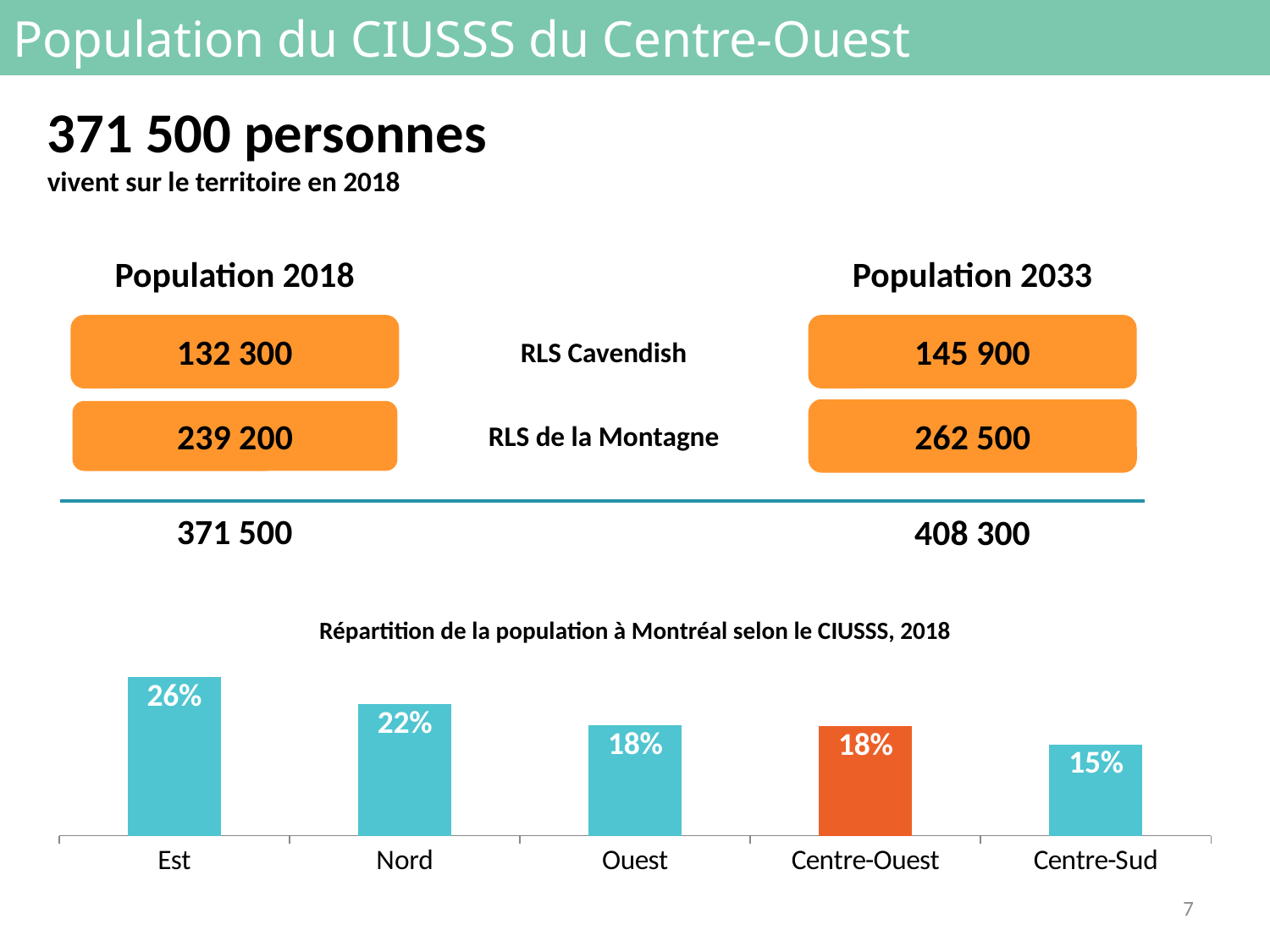
Which bar in the chart is coloured orange rather than blue? Centre-Ouest Which is larger in the chart, the value for Nord or the value for Ouest? Nord What is the value for Centre-Ouest in the chart? 18% What is the value for Centre-Sud in the chart? 15% Which category has the highest value in the chart? Est What is the difference between the values for Centre-Ouest and Centre-Sud in the chart? 3% What is the value for Nord in the chart? 22% What is the difference between the values for Est and Nord in the chart? 4% Which category has the lowest value in the chart? Centre-Sud What kind of chart is shown at the bottom of the slide? Bar chart How many categories are shown in the chart? 5 What is the value for Est in the chart 'Répartition de la population à Montréal selon le CIUSSS, 2018'? 26%